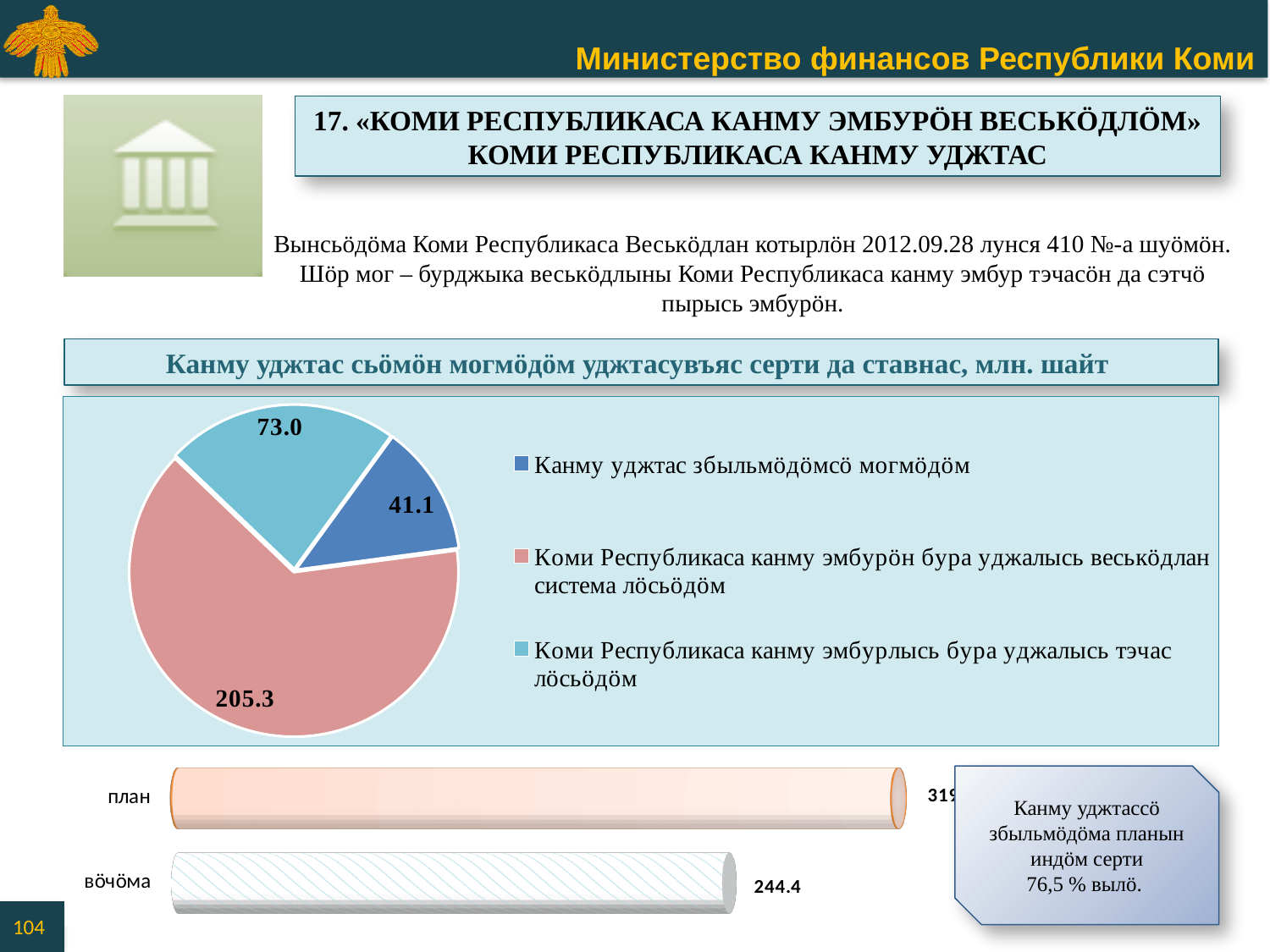
In the lower bar chart, which bar is longer, «план» or «вöчöма»? план What kind of chart is the upper chart titled «Канму уджтас сьöмöн могмöдöм уджтасувъяс серти да ставнас, млн. шайт»? pie chart In the pie chart, which category has the smallest slice? Канму уджтас збыльмöдöмсö могмöдöм In the pie chart, what is the value for «Коми Республикаса канму эмбурöн бура уджалысь веськöдлан система лöсьöдöм»? 205.3 In the pie chart, what is the total of the three slice values? 319.4 In the pie chart, what is the value for «Канму уджтас збыльмöдöмсö могмöдöм»? 41.1 In the pie chart, what is the difference between the largest slice (205.3) and the smallest slice (41.1)? 164.2 In the pie chart, which category has the largest slice? Коми Республикаса канму эмбурöн бура уджалысь веськöдлан система лöсьöдöм How many slices does the pie chart have? 3 How many entries does the legend of the pie chart list? 3 In the pie chart, what is the value for «Коми Республикаса канму эмбурлысь бура уджалысь тэчас лöсьöдöм»? 73.0 In the lower bar chart, what is the value for «вöчöма»? 244.4